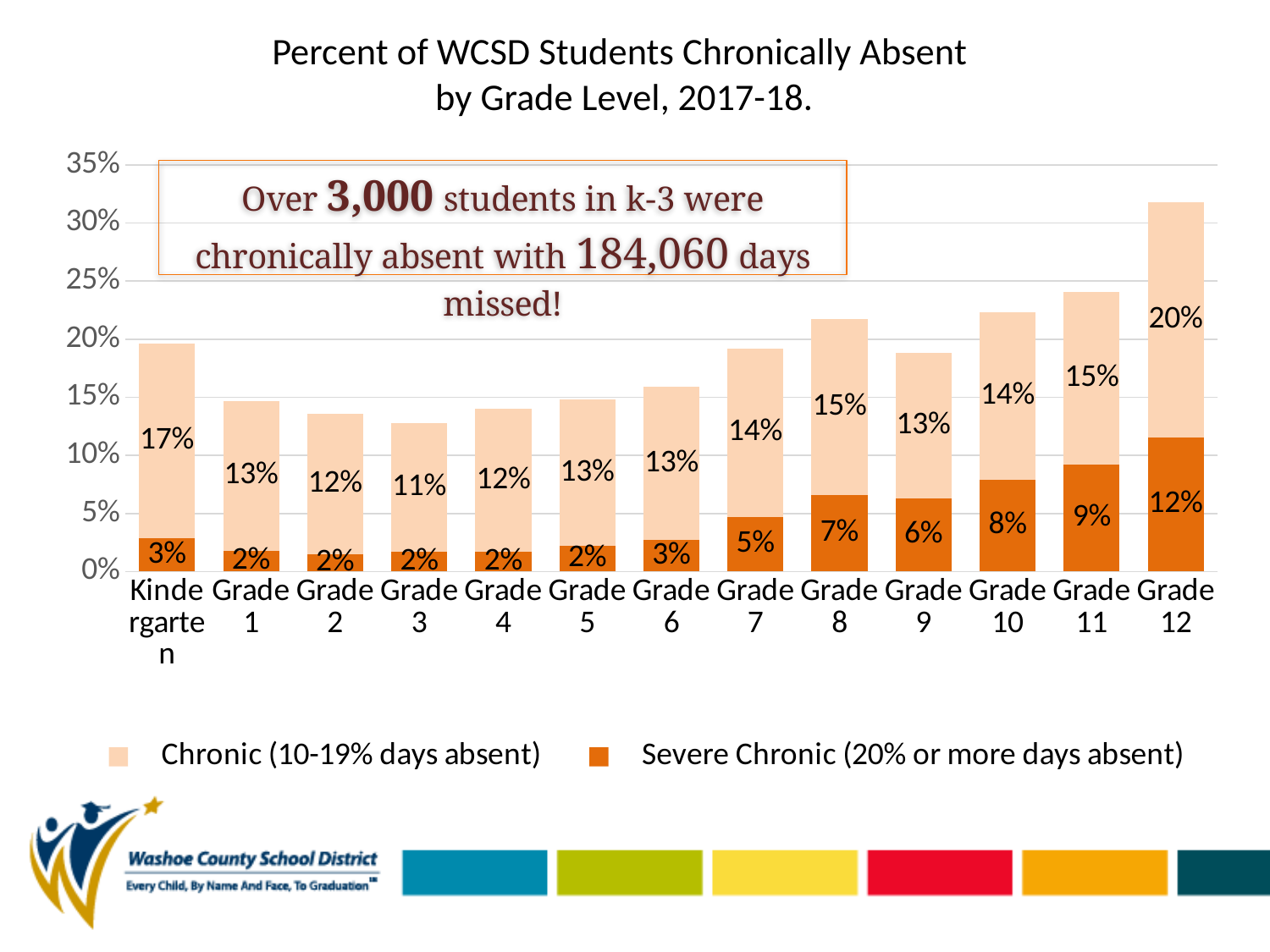
Which grade level has the highest Severe Chronic (20% or more days absent) value? Grade 12 Is the total height of the Grade 12 bar greater or less than 30%? greater What is the Chronic (10-19% days absent) value for Kindergarten? 17% Which grade level has the lowest Chronic (10-19% days absent) value? Grade 3 How many grade levels are shown on the x axis? 13 What is the Chronic (10-19% days absent) value for Grade 12? 20% How many series does the legend list? 2 What is the Severe Chronic (20% or more days absent) value for Grade 8? 7% What kind of chart is shown on the slide? Stacked bar chart What is the total of the Grade 12 bar, adding the Chronic and Severe Chronic values? 32% Which is larger, the Severe Chronic value for Grade 11 or the Severe Chronic value for Grade 7? Grade 11 What is the difference between the Severe Chronic value for Grade 12 and the Severe Chronic value for Kindergarten? 9 percentage points